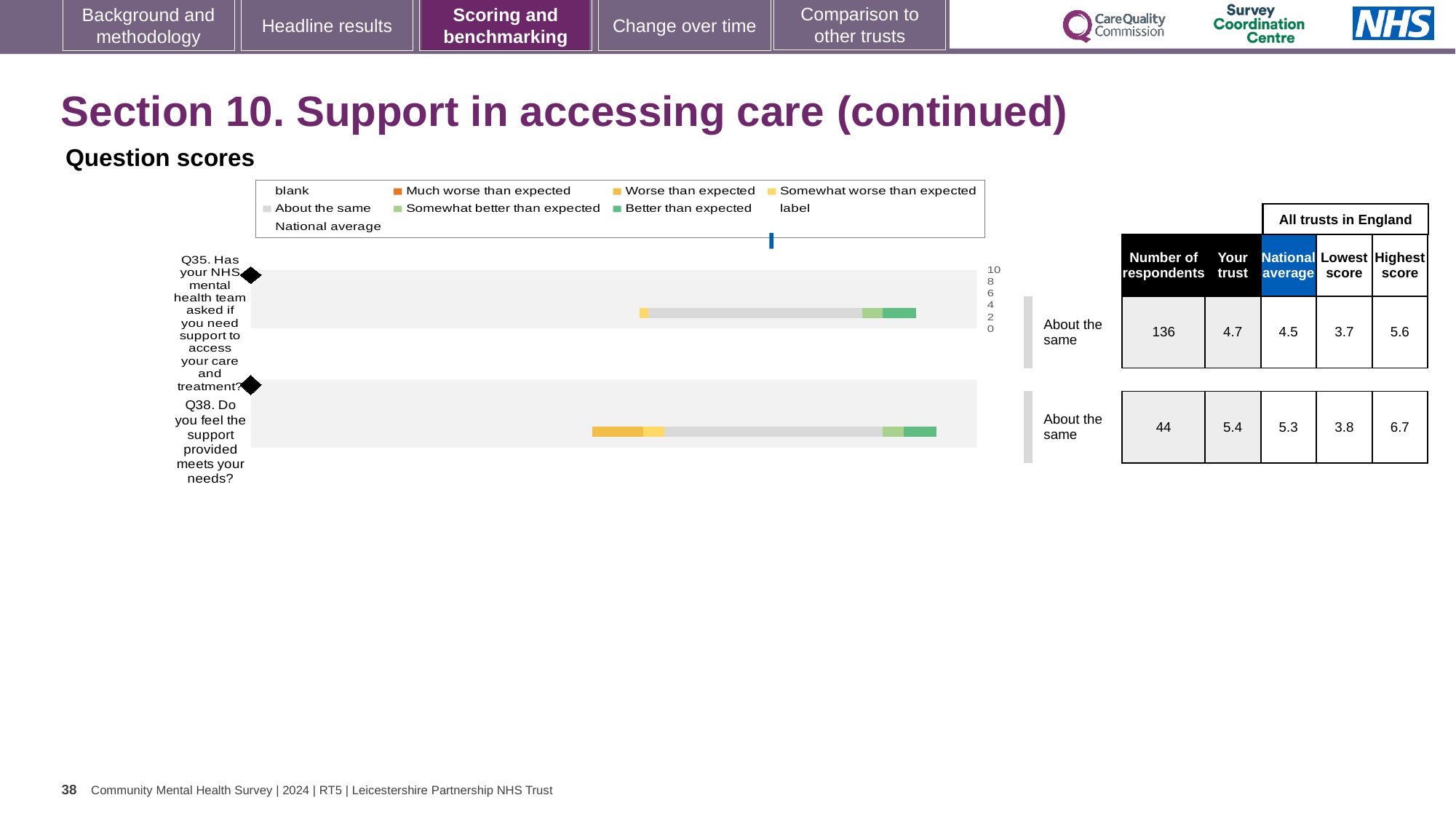
What is the 'Your trust' score for Q38 (Do you feel the support provided meets your needs?)? 5.4 How many questions are plotted in the chart? 2 What is the difference between the 'Your trust' score and the national average for Q35? 0.2 What is the difference between the highest and lowest scores for Q38? 2.9 How many respondents answered Q35? 136 What is the national average score for Q38? 5.3 Which question has the higher 'Your trust' score, Q35 or Q38? Q38 What is the highest score among all trusts in England for Q38? 6.7 What kind of chart is used to show the question scores? Bar chart What is the lowest score among all trusts in England for Q35? 3.7 What is the national average score for Q35? 4.5 What is the 'Your trust' score for Q35 (Has your NHS mental health team asked if you need support to access your care and treatment?)? 4.7